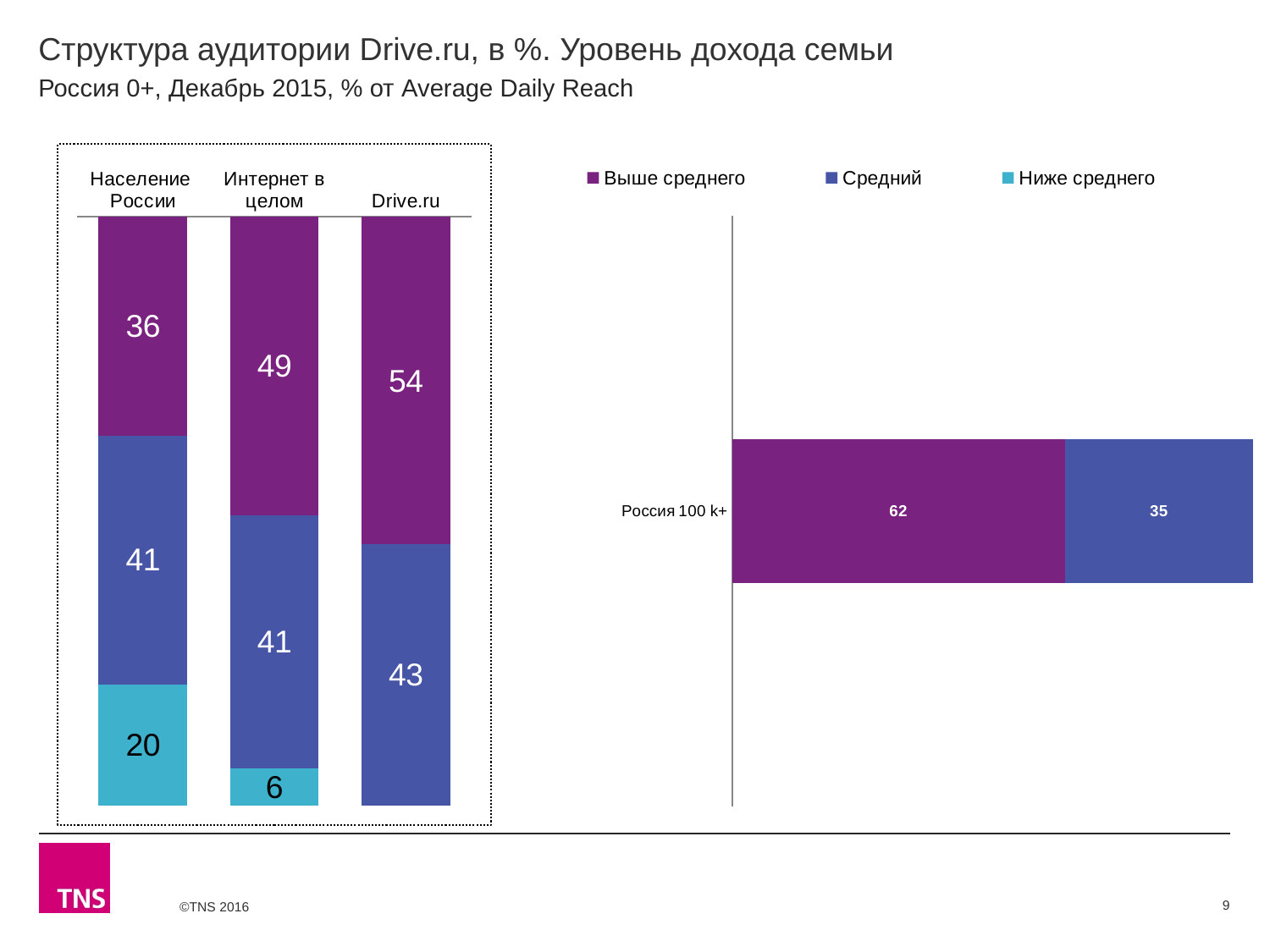
In the left chart, what is the value of 'Выше среднего' for Drive.ru? 54 How many categories are shown in the left chart? 3 In the right chart, what is the difference between the 'Выше среднего' and 'Средний' values for 'Россия 100 k+'? 27 How many series does the legend list? 3 In the left chart, which category has the lowest value for 'Ниже среднего' among those with a printed label? Интернет в целом What kind of chart is the right chart? Stacked bar chart In the right chart, what is the value of 'Выше среднего' for 'Россия 100 k+'? 62 In the left chart, what is the value of 'Средний' for 'Интернет в целом'? 41 In the left chart, what is the difference between the 'Выше среднего' values for Drive.ru and 'Население России'? 18 In the left chart, which is larger: 'Средний' for Drive.ru or 'Средний' for 'Население России'? Drive.ru In the left chart, what is the value of 'Ниже среднего' for 'Население России'? 20 In the left chart, which category has the highest value for 'Выше среднего'? Drive.ru